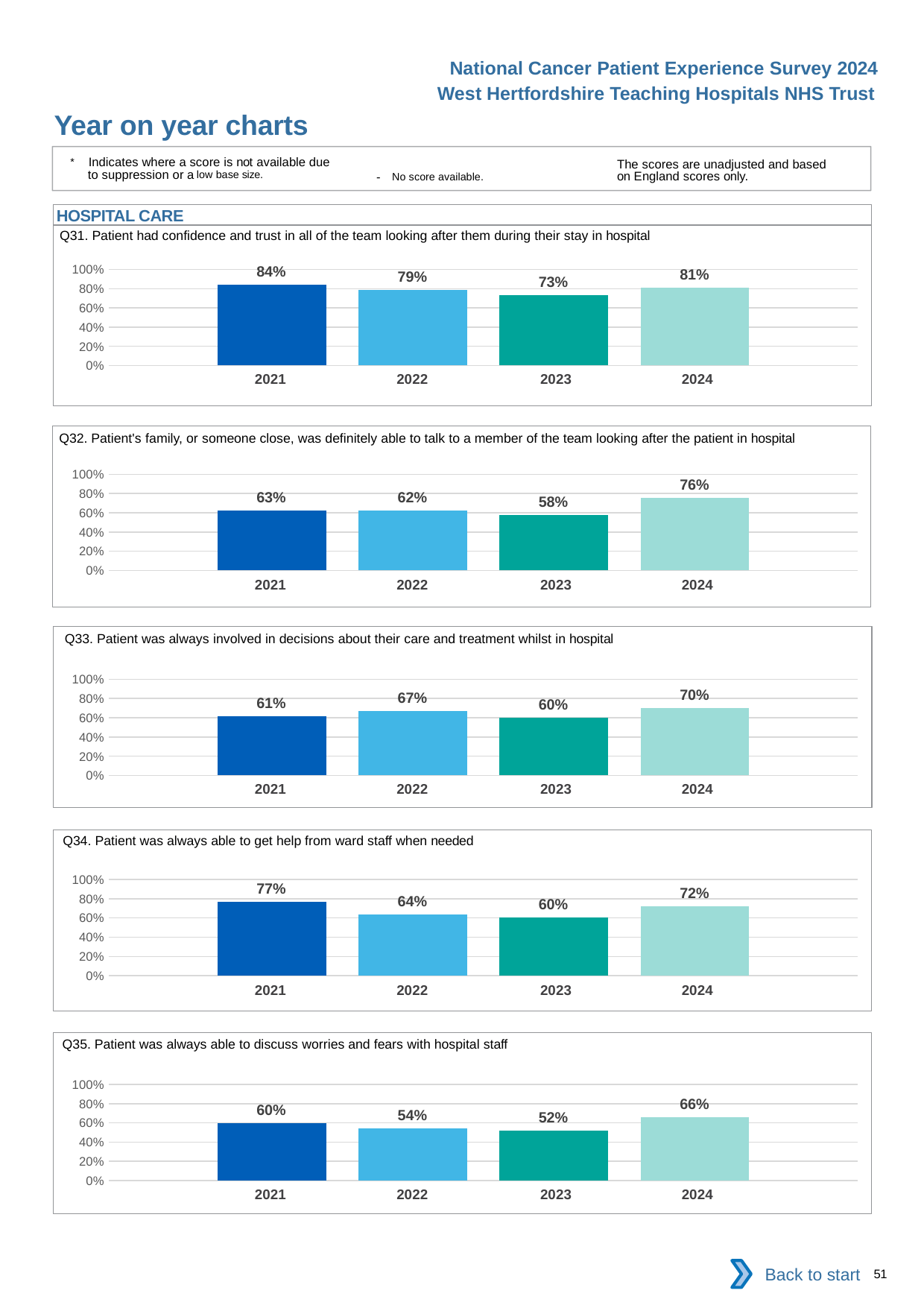
In the Q32 chart, what is the difference between the 2024 and 2023 values? 18 percentage points In the Q34 chart, what is the value for 2022? 64% In the Q34 chart, what is the difference between the 2021 and 2023 values? 17 percentage points How many years are shown on the x axis of the Q31 chart? 4 In the Q35 chart, is the value for 2024 greater or less than 60%? greater In the Q32 chart, what is the value for 2024? 76% In the Q33 chart, is the value for 2022 larger or smaller than the value for 2023? larger In the Q33 chart, which year has the highest value? 2024 In the Q35 chart, what is the value for 2023? 52% In the Q31 chart, what is the value for 2021? 84% In the Q31 chart, which year has the lowest value? 2023 What type of chart is the Q35 chart? bar chart